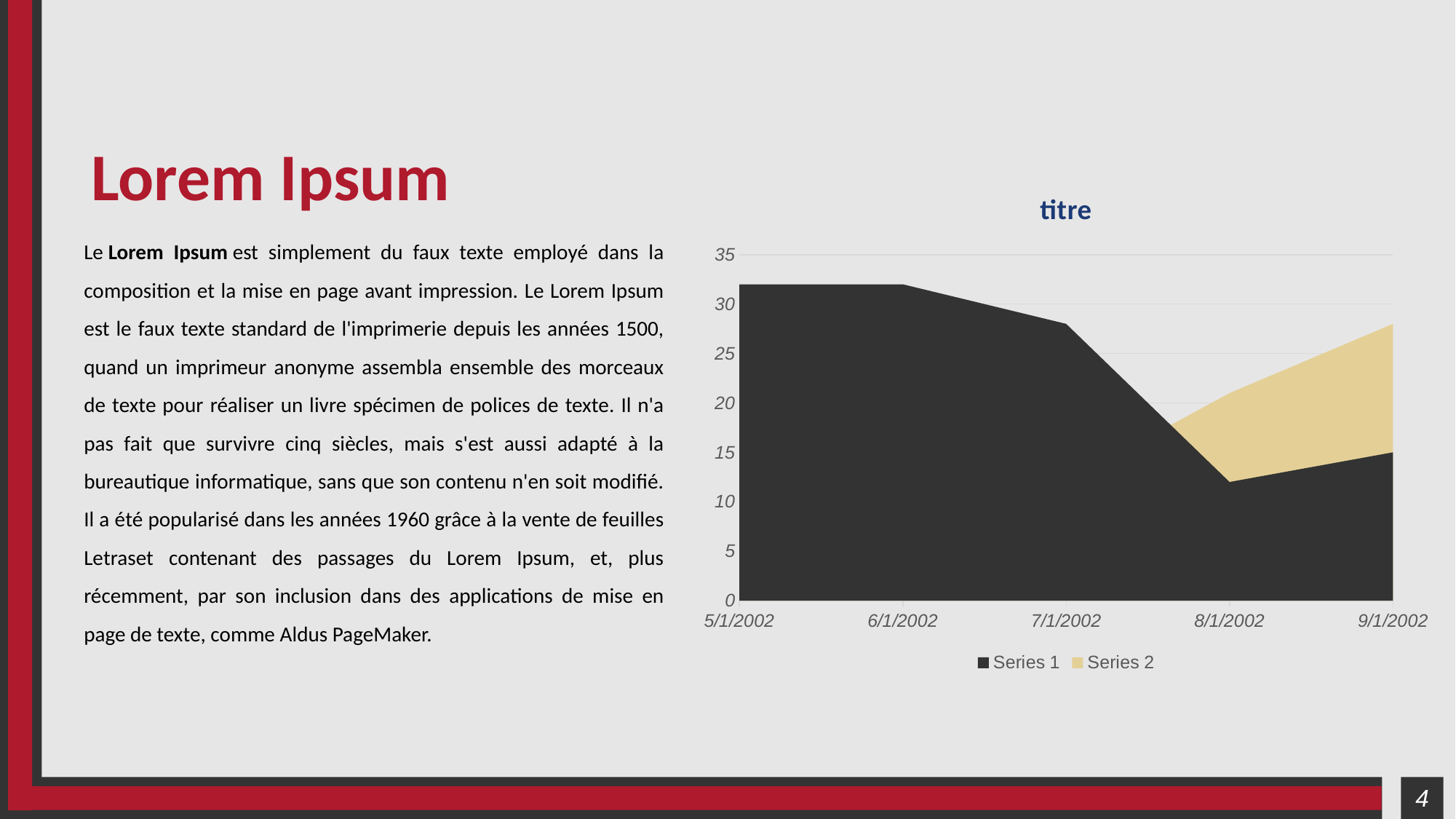
What kind of chart is shown on the slide? area chart Does Series 1 rise or fall between 6/1/2002 and 8/1/2002? fall Is the value of Series 1 at 7/1/2002 greater or less than 30? less Which series is drawn in the dark colour in the chart? Series 1 At which date does Series 1 reach its lowest value? 8/1/2002 How many dates are shown along the x axis of the chart? 5 Is the value of Series 1 at 5/1/2002 greater or less than 30? greater What is the title of the chart? titre Is the value of Series 1 at 8/1/2002 greater or less than 15? less How many series does the chart legend list? 2 Which is larger for Series 1: the value at 7/1/2002 or the value at 8/1/2002? 7/1/2002